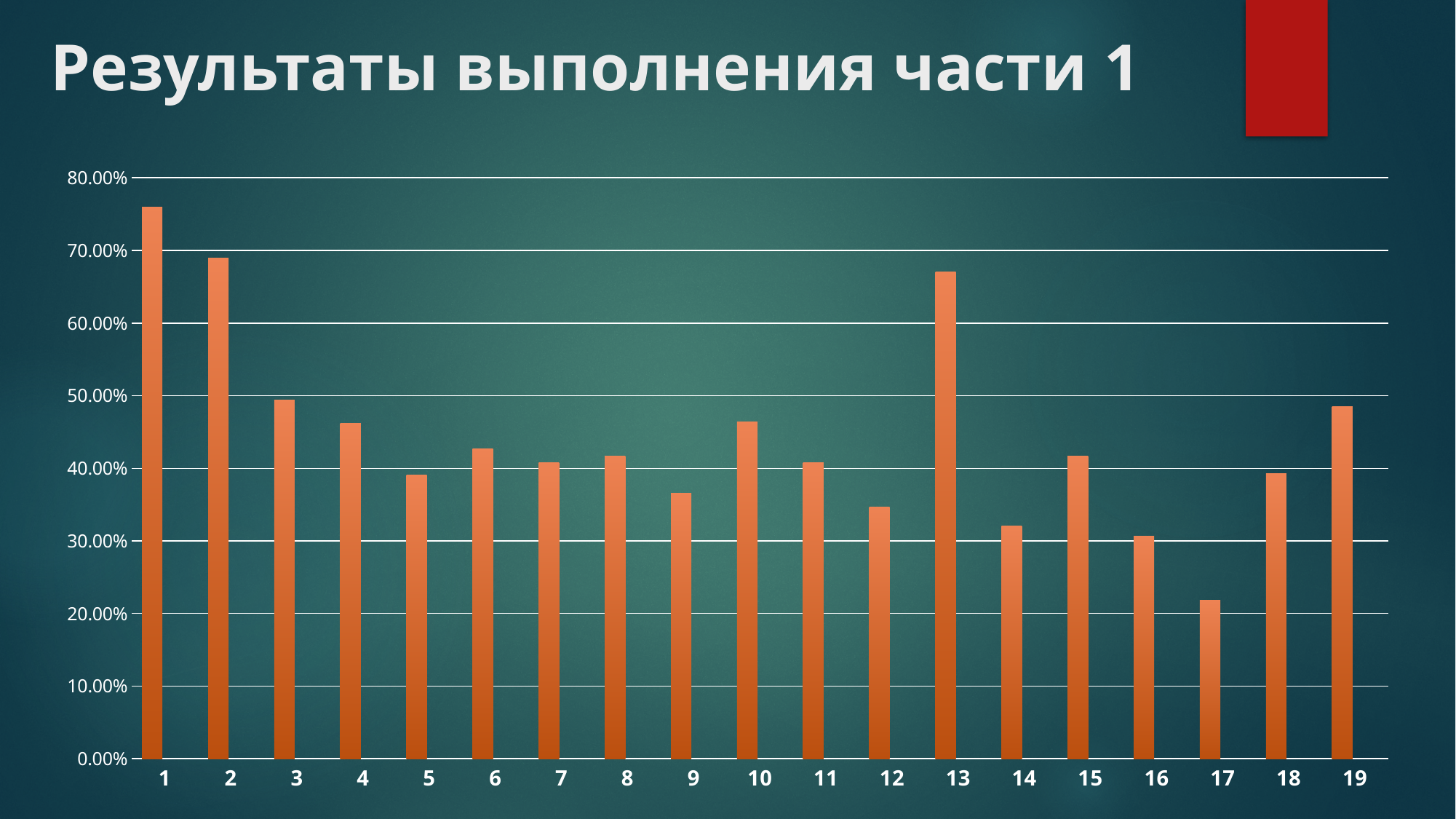
Is the value for category 12 greater or less than 40.00%? less Which category has the highest value? 1 Is the value for category 17 greater or less than 20.00%? greater Which is larger, the value for category 1 or category 2? 1 How many categories are plotted on the x axis? 19 What is the title of the slide? Результаты выполнения части 1 What kind of chart is shown on the slide? bar chart Is the value for category 13 greater or less than 60.00%? greater Which is larger, the value for category 4 or category 5? 4 What is the highest tick label shown on the y axis? 80.00% Which category has the lowest value? 17